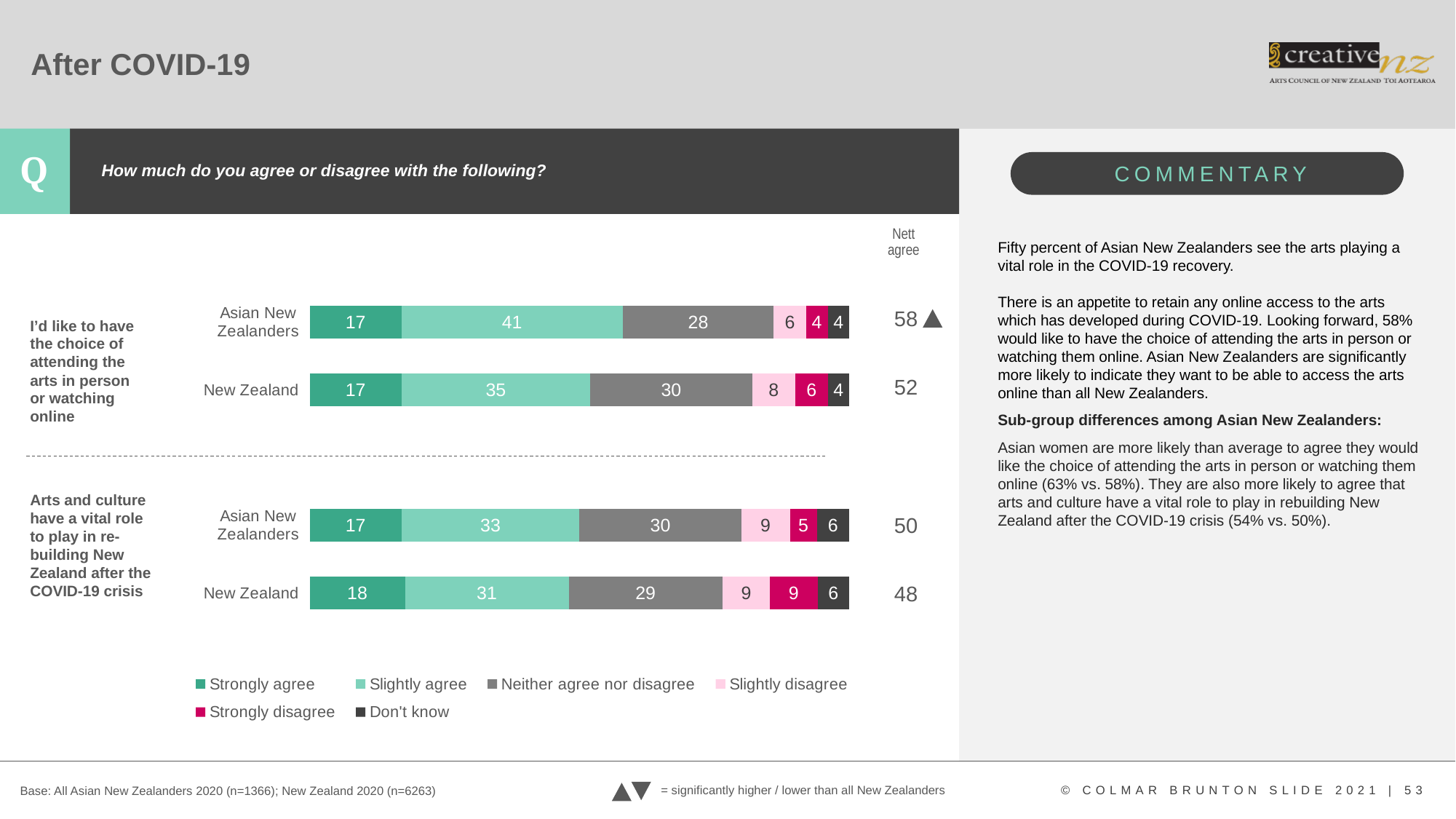
What is the 'Slightly agree' value for Asian New Zealanders on the statement 'I'd like to have the choice of attending the arts in person or watching online'? 41 Which legend entry is shown in dark grey/black? Don't know What is the difference in Nett agree between Asian New Zealanders and New Zealand on the statement about having the choice of attending the arts in person or watching online? 6 Which bar has the lowest Nett agree figure? New Zealand, arts and culture have a vital role in re-building New Zealand How many series does the chart legend list? 6 For the statement about arts and culture having a vital role in re-building New Zealand, which group has the larger 'Strongly disagree' value, Asian New Zealanders or New Zealand? New Zealand How many bars are plotted in the chart? 4 What kind of chart is shown on the slide? Stacked bar chart What is the 'Strongly disagree' value for Asian New Zealanders on the statement about having the choice of attending the arts in person or watching online? 4 Which bar has the highest Nett agree figure? Asian New Zealanders, choice of attending in person or watching online What is the Nett agree figure for Asian New Zealanders on the statement about having the choice of attending the arts in person or watching online? 58 What is the 'Neither agree nor disagree' value for New Zealand on the statement 'Arts and culture have a vital role to play in re-building New Zealand after the COVID-19 crisis'? 29